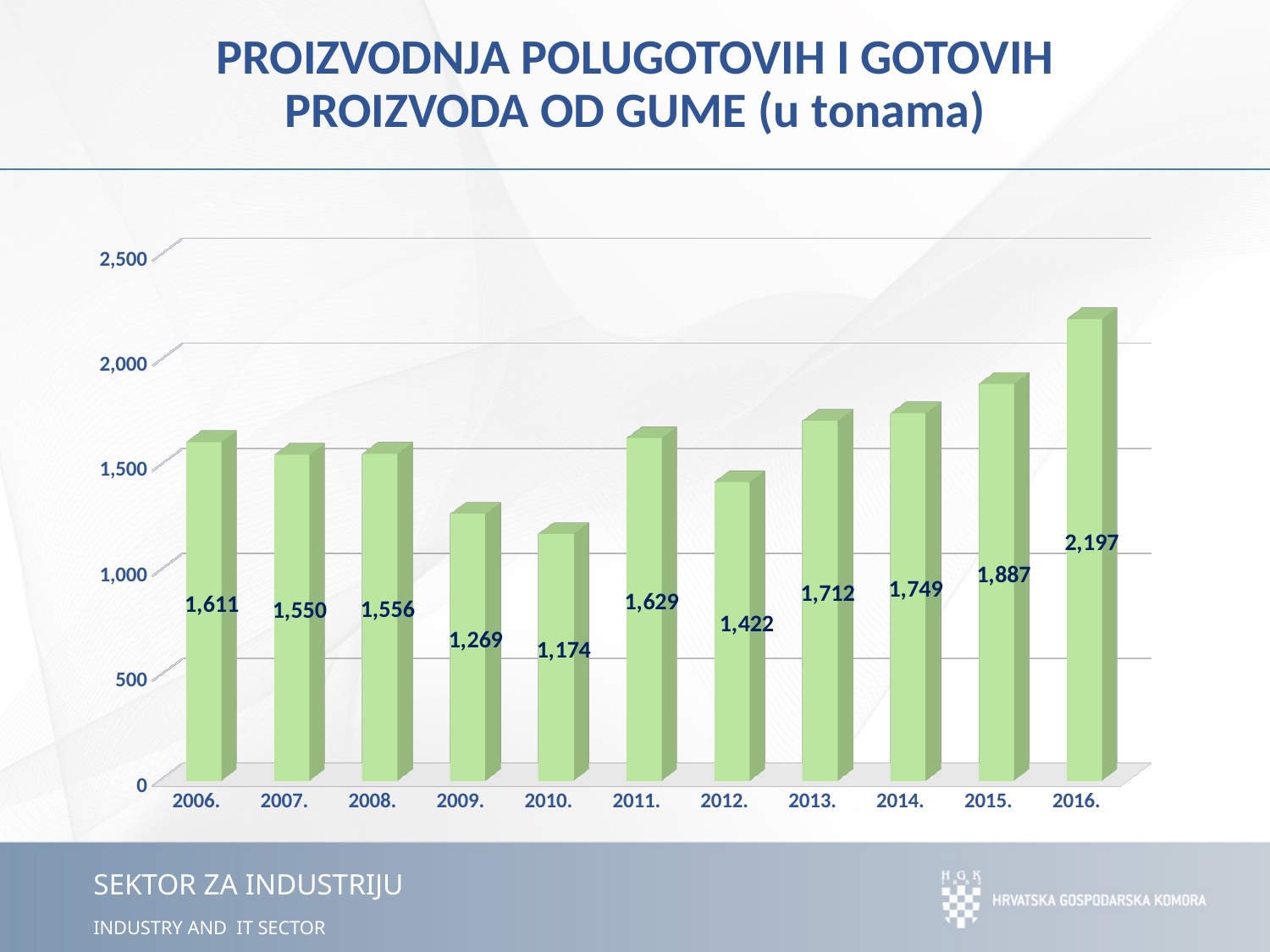
What is the value for 2006.? 1,611 Do the values rise or fall from 2010. to 2016.? rise overall, with a dip in 2012. Which is larger, the value for 2011. or the value for 2012.? 2011. What is the difference between the values for 2009. and 2010.? 95 Which year has the highest value? 2016. How many years are shown on the x axis? 11 Which year has the lowest value? 2010. What is the value for 2013.? 1,712 What kind of chart is shown on the slide? bar chart What is the value for 2010.? 1,174 What is the difference between the values for 2016. and 2015.? 310 Is the value for 2014. greater or less than 1,500? greater